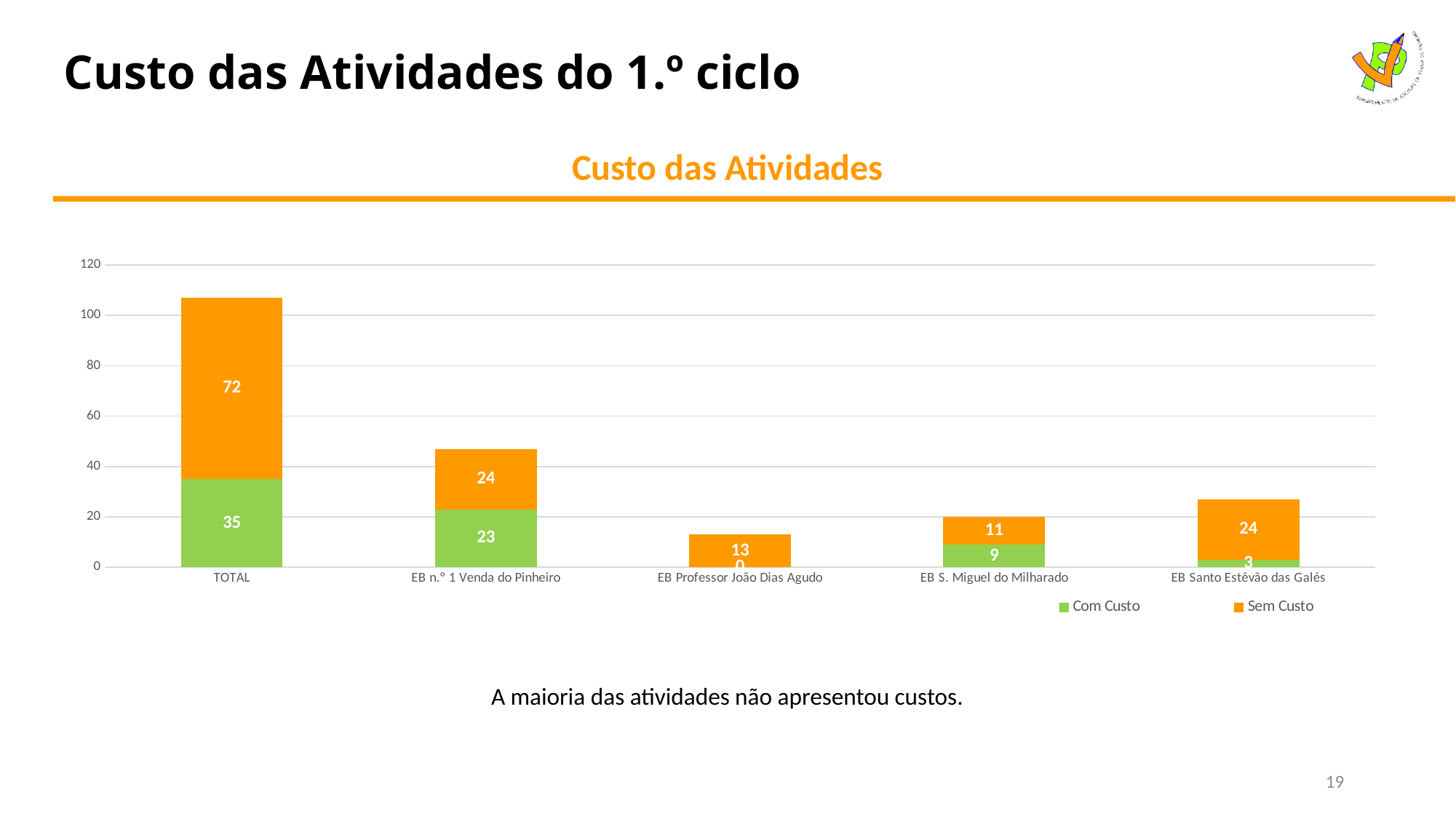
Which school (excluding TOTAL) has the highest Com Custo value? EB n.º 1 Venda do Pinheiro How many series does the legend list? 2 What is the Sem Custo value for EB Santo Estêvão das Galés? 24 What is the total of the stacked bar for EB S. Miguel do Milharado? 20 What kind of chart is shown on the slide? Stacked bar chart How many categories are shown on the x axis? 5 Which category has the lowest Sem Custo value? EB Professor João Dias Agudo What is the title of the chart? Custo das Atividades What is the Com Custo value for EB Professor João Dias Agudo? 0 What is the Sem Custo value for TOTAL? 72 What is the difference between the Sem Custo and Com Custo values for TOTAL? 37 What is the Com Custo value for EB n.º 1 Venda do Pinheiro? 23